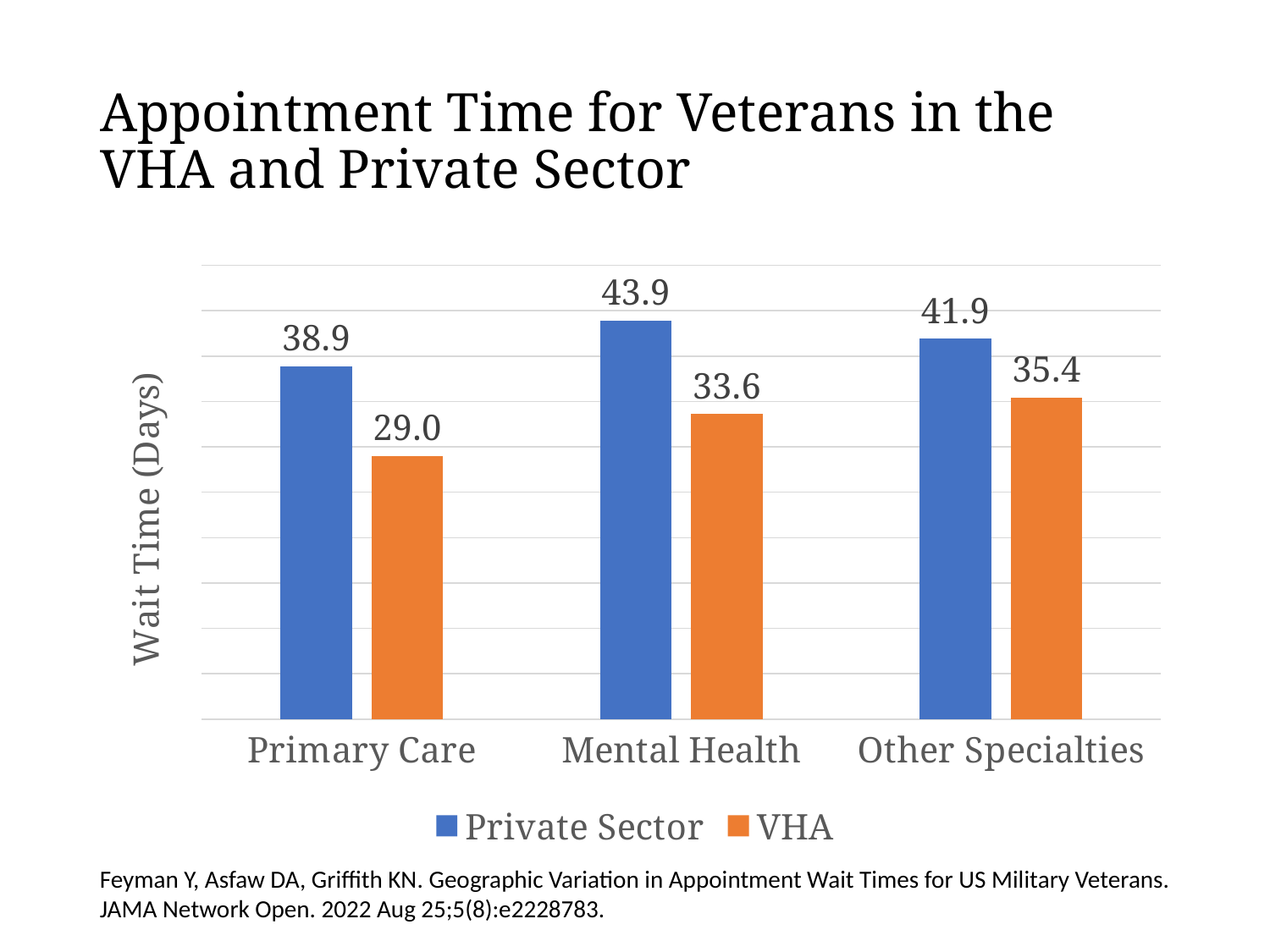
Which category has the lowest VHA wait time? Primary Care How many categories are shown on the x axis? 3 What is the VHA wait time for Mental Health? 33.6 For Other Specialties, which is larger: the Private Sector or the VHA wait time? Private Sector What is the difference between the Private Sector and VHA wait times for Mental Health? 10.3 Which category has the highest Private Sector wait time? Mental Health What is the VHA wait time for Other Specialties? 35.4 How many series does the legend list? 2 What kind of chart is shown on the slide? Bar chart What is the Private Sector wait time for Primary Care? 38.9 What is the difference between the Private Sector and VHA wait times for Primary Care? 9.9 What is the label of the vertical axis? Wait Time (Days)